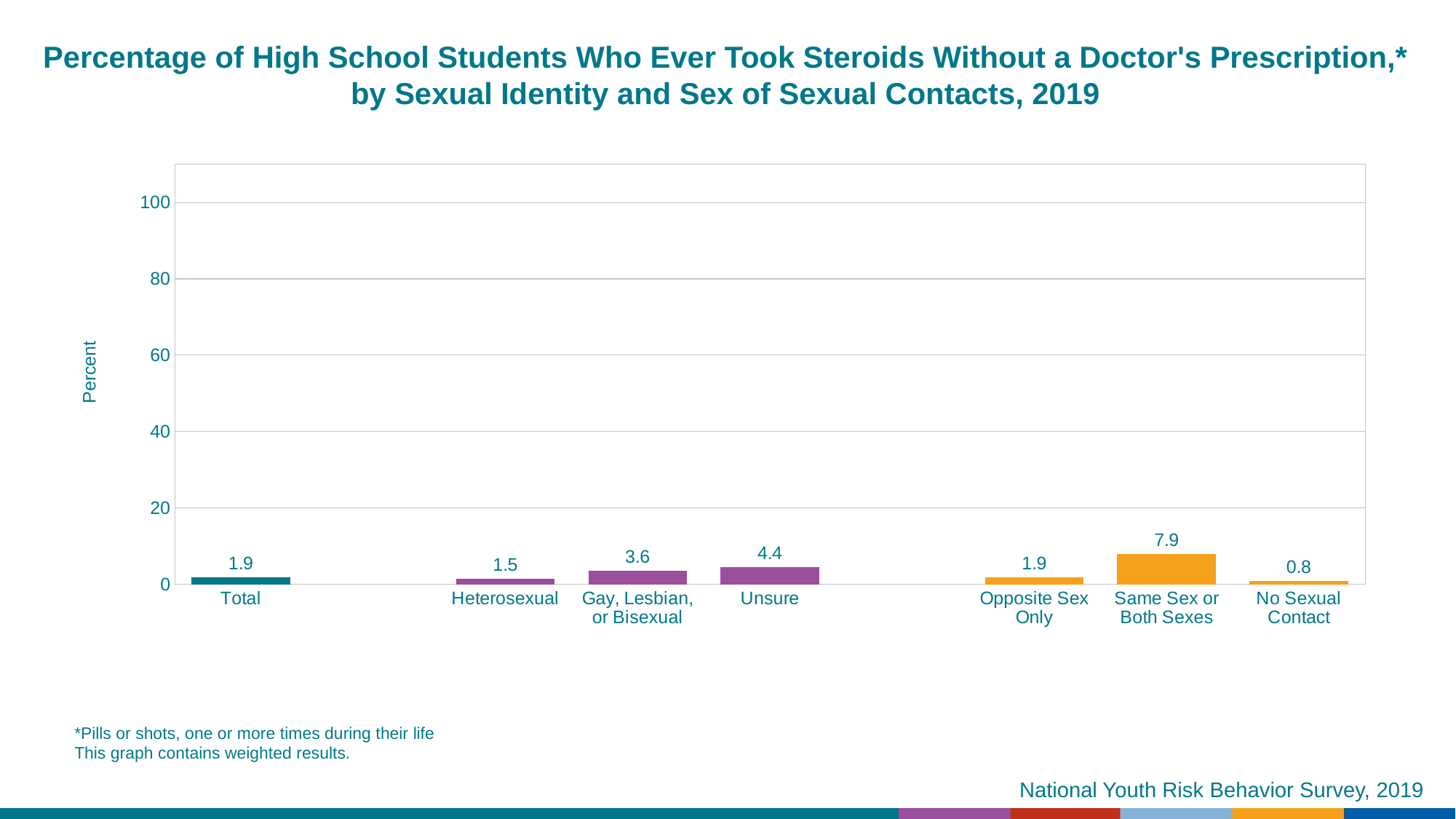
What is the value for Same Sex or Both Sexes? 7.9 What kind of chart is this? bar chart What is the value for Heterosexual? 1.5 What is the value for No Sexual Contact? 0.8 What is the value for Total? 1.9 Which is larger, the value for Gay, Lesbian, or Bisexual or the value for Unsure? Unsure What is the label on the y axis? Percent Which category has the lowest value? No Sexual Contact What is the difference between the values for Unsure and Heterosexual? 2.9 Is the value for Same Sex or Both Sexes greater or less than 20? less Which category has the highest value? Same Sex or Both Sexes How many categories are shown on the x axis? 7